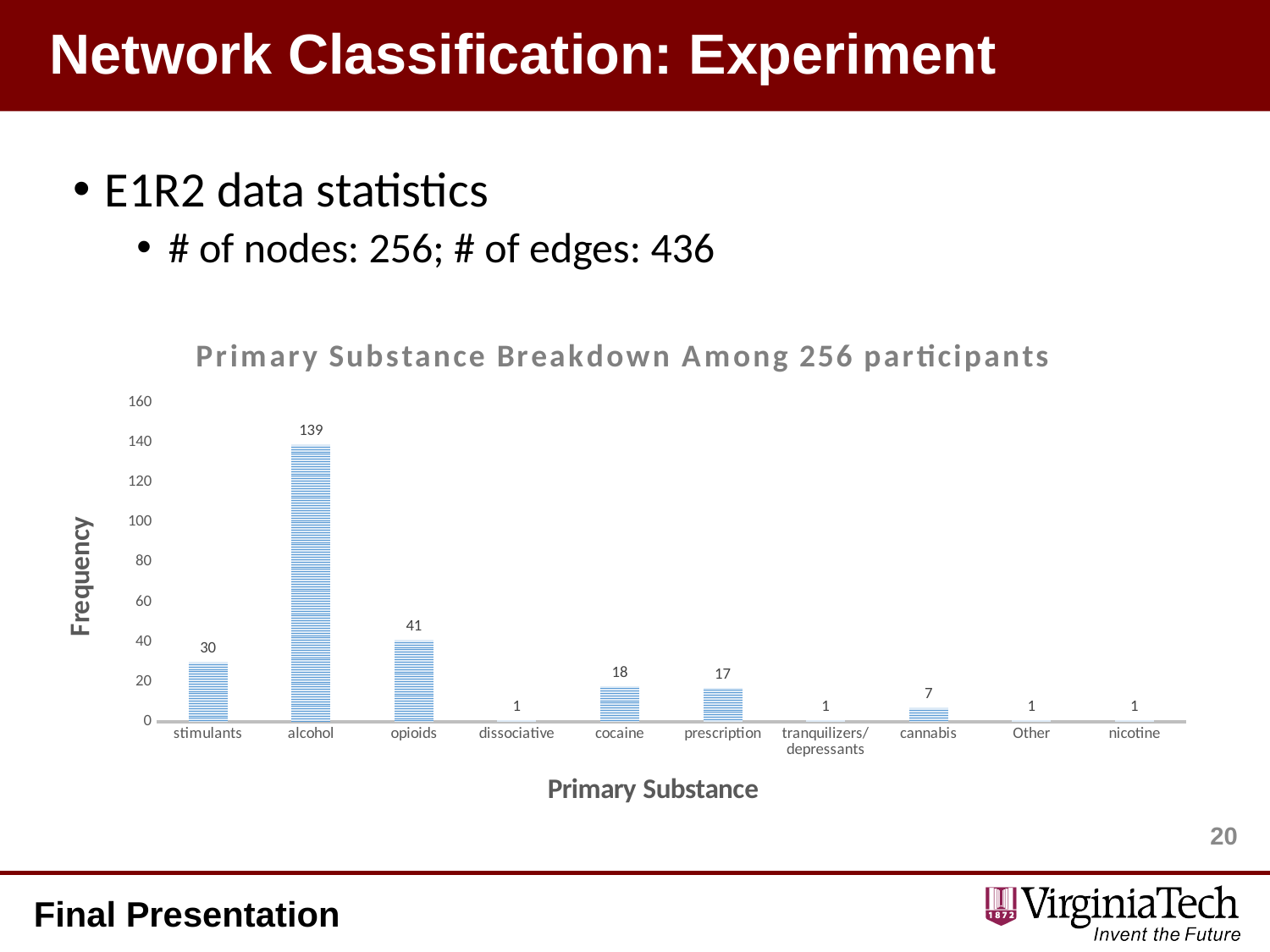
Which has a higher frequency, stimulants or opioids? opioids Which primary substance has the highest frequency? alcohol What is the frequency for cannabis? 7 What kind of chart is shown on the slide? bar chart How many primary substance categories are shown on the x axis? 10 What is the frequency for alcohol? 139 What is the difference in frequency between alcohol and opioids? 98 What is the frequency for opioids? 41 What is the title of the chart? Primary Substance Breakdown Among 256 participants Is the value for alcohol greater or less than 120? greater What is the difference in frequency between opioids and stimulants? 11 What is the frequency for cocaine? 18